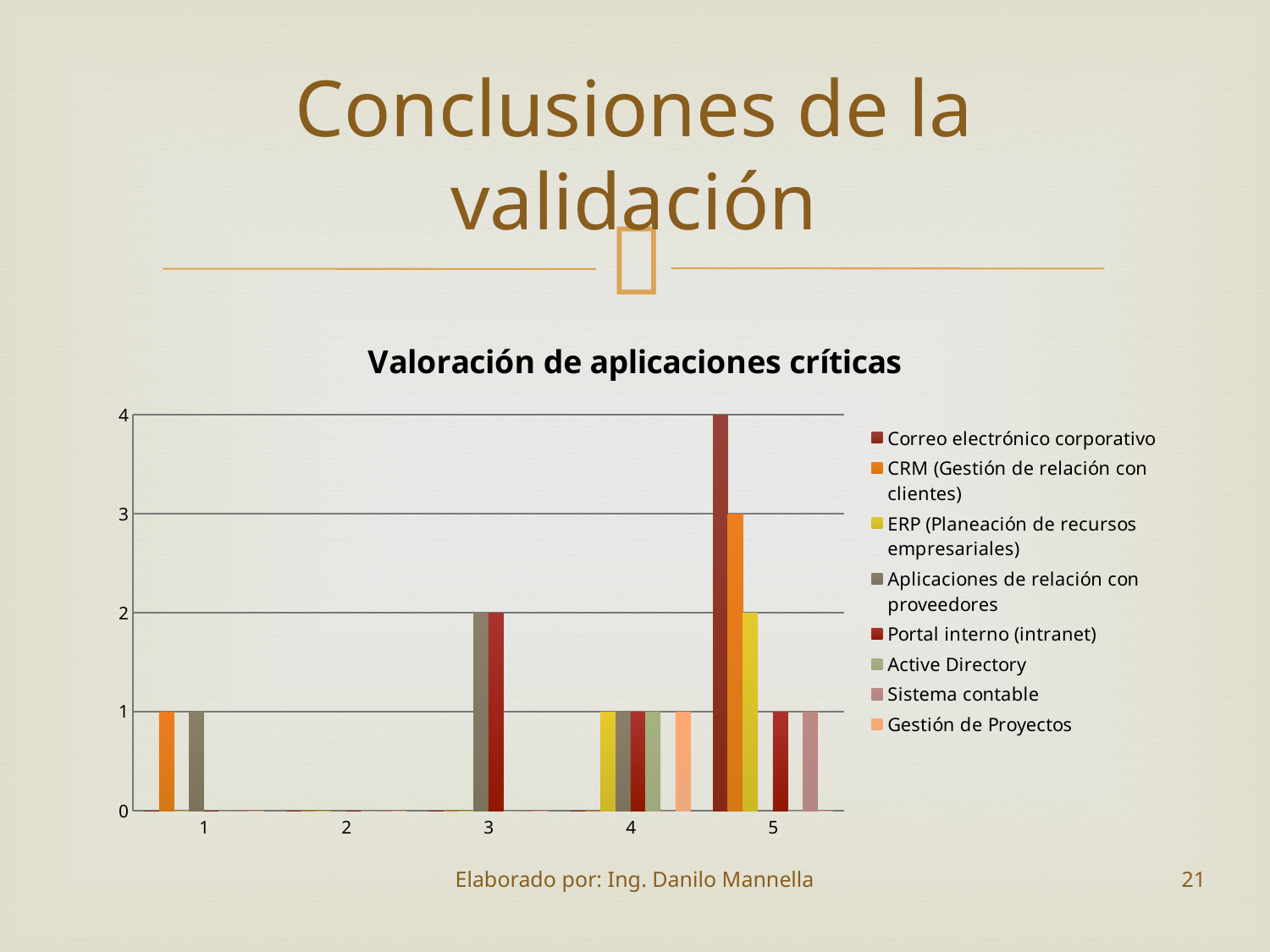
What is the difference between Correo electrónico corporativo and CRM (Gestión de relación con clientes) at category 5? 1 Which is larger at category 5: CRM (Gestión de relación con clientes) or ERP (Planeación de recursos empresariales)? CRM (Gestión de relación con clientes) What is the value for ERP (Planeación de recursos empresariales) at category 5? 2 What is the value for CRM (Gestión de relación con clientes) at category 1? 1 What kind of chart is shown on the slide? Bar chart What is the value for Portal interno (intranet) at category 3? 2 What is the value for Correo electrónico corporativo at category 5? 4 What is the value for CRM (Gestión de relación con clientes) at category 5? 3 How many series does the legend list? 8 What is the title of the chart? Valoración de aplicaciones críticas How many categories are shown on the x axis? 5 Which series has the highest value at category 5? Correo electrónico corporativo